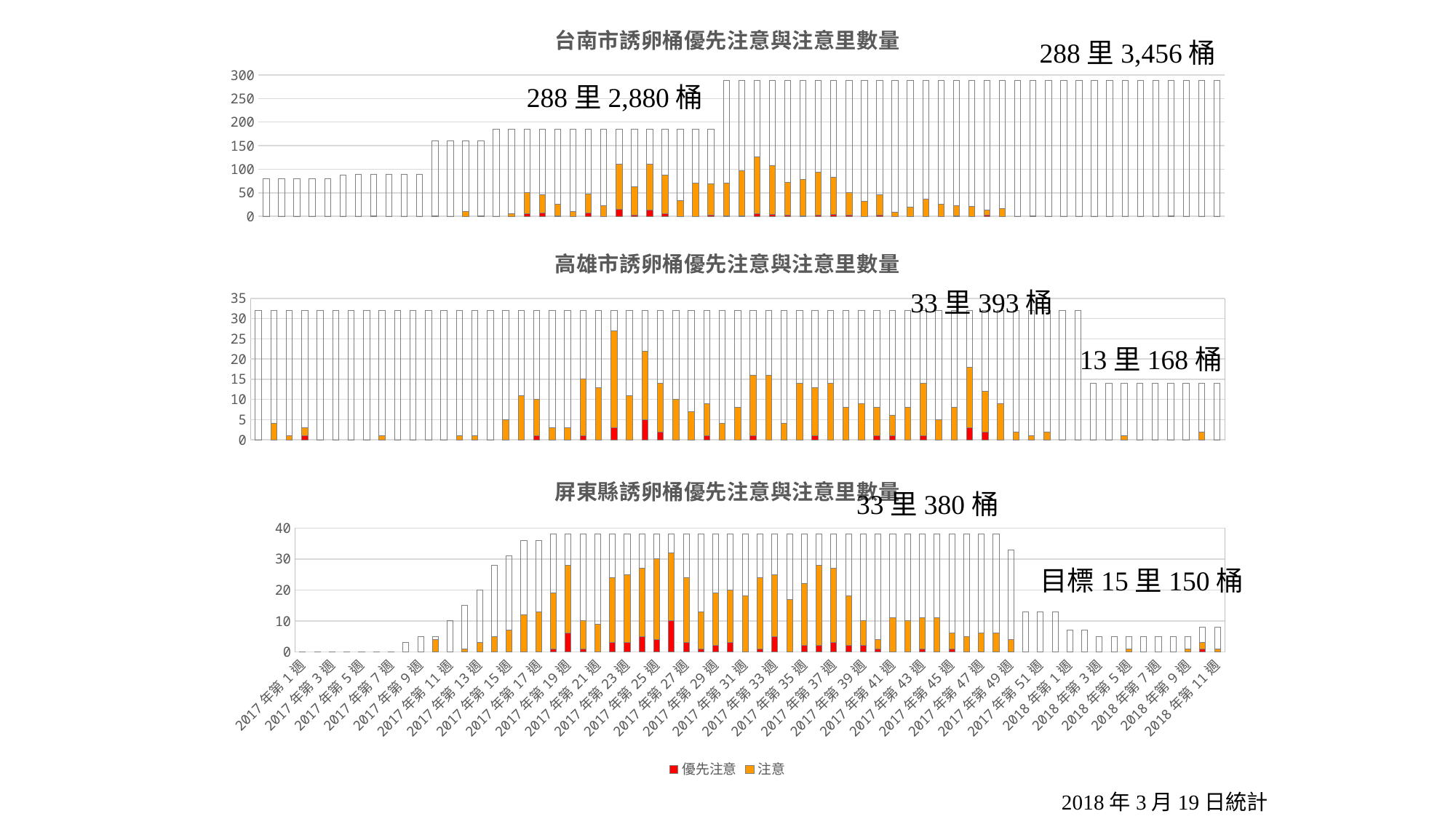
How many series does the legend at the bottom of the slide list? 2 In the 屏東縣 chart, do the stacked values generally rise or fall from 2017年第37週 to 2017年第49週? fall In the 屏東縣 chart, is the total stacked value for 2017年第19週 greater or less than 20? greater In the 台南市 chart, is the tallest stacked bar greater or less than 100? greater In the 屏東縣 chart, is the total stacked value for 2017年第27週 greater or less than 20? greater What kind of chart is the 台南市誘卵桶優先注意與注意里數量 chart? bar chart How many charts are shown on the slide? 3 In the 屏東縣 chart, which has the larger total stacked value: 2017年第27週 or 2017年第49週? 2017年第27週 What is the title of the top chart on the slide? 台南市誘卵桶優先注意與注意里數量 What are the two series named in the legend? 優先注意 and 注意